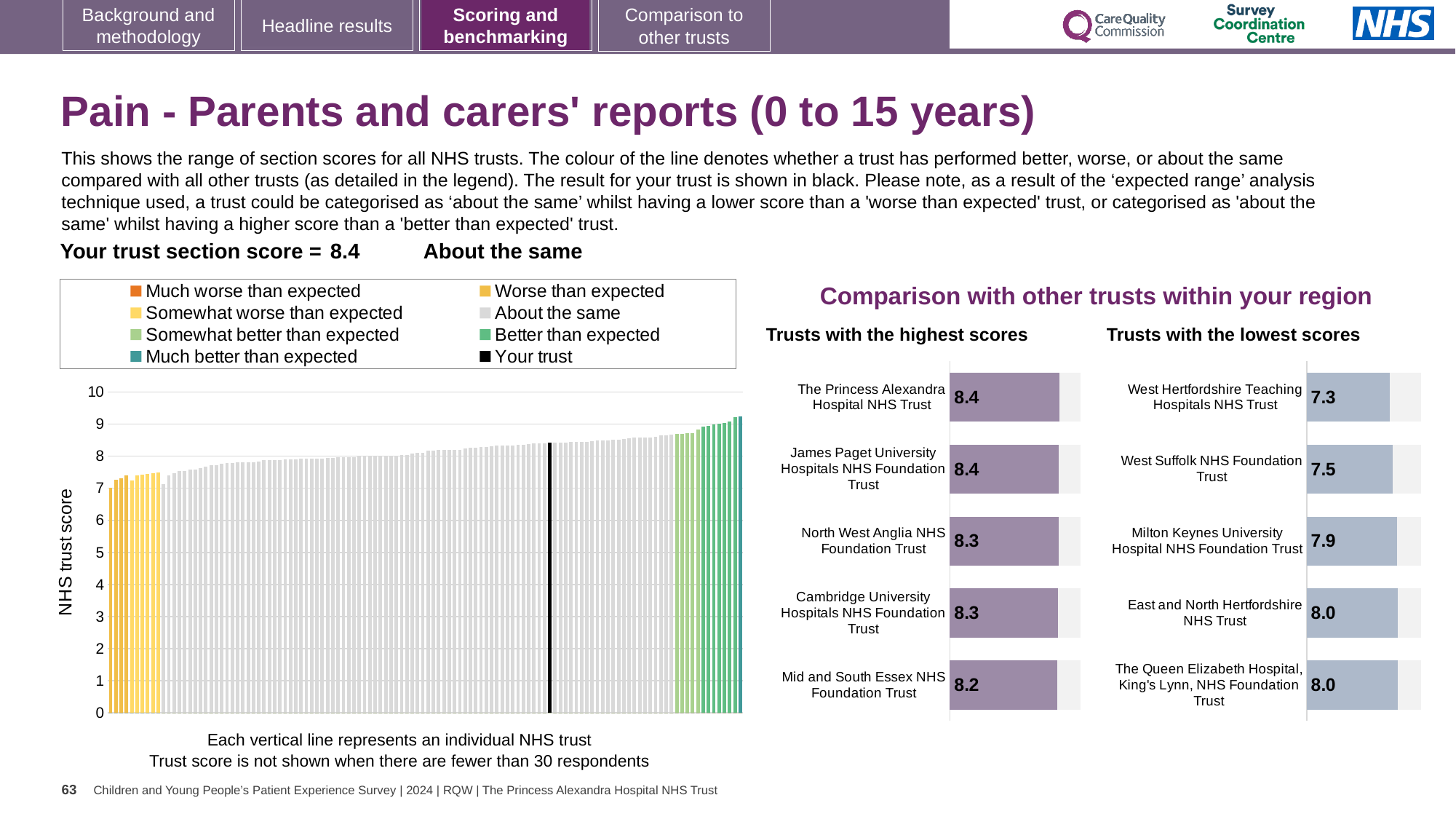
In the 'Trusts with the highest scores' chart, what is the score for Mid and South Essex NHS Foundation Trust? 8.2 In the 'Trusts with the highest scores' chart, which trust has the lowest score? Mid and South Essex NHS Foundation Trust In the 'Trusts with the lowest scores' chart, what is the difference between the scores of Milton Keynes University Hospital NHS Foundation Trust and West Hertfordshire Teaching Hospitals NHS Trust? 0.6 How many trusts are listed in the 'Trusts with the lowest scores' chart? 5 How many entries does the legend of the large chart on the left list? 8 In the 'Trusts with the lowest scores' chart, which has the larger score: West Suffolk NHS Foundation Trust or East and North Hertfordshire NHS Trust? East and North Hertfordshire NHS Trust In the 'Trusts with the highest scores' chart, what is the score for North West Anglia NHS Foundation Trust? 8.3 In the 'Trusts with the lowest scores' chart, what is the score for West Suffolk NHS Foundation Trust? 7.5 In the large chart on the left, is the value for the black 'Your trust' bar greater or less than 8? greater In the 'Trusts with the highest scores' chart, what is the difference between the scores of The Princess Alexandra Hospital NHS Trust and Mid and South Essex NHS Foundation Trust? 0.2 What kind of chart is the large chart on the left showing NHS trust scores? Bar chart In the 'Trusts with the lowest scores' chart, which trust has the lowest score? West Hertfordshire Teaching Hospitals NHS Trust